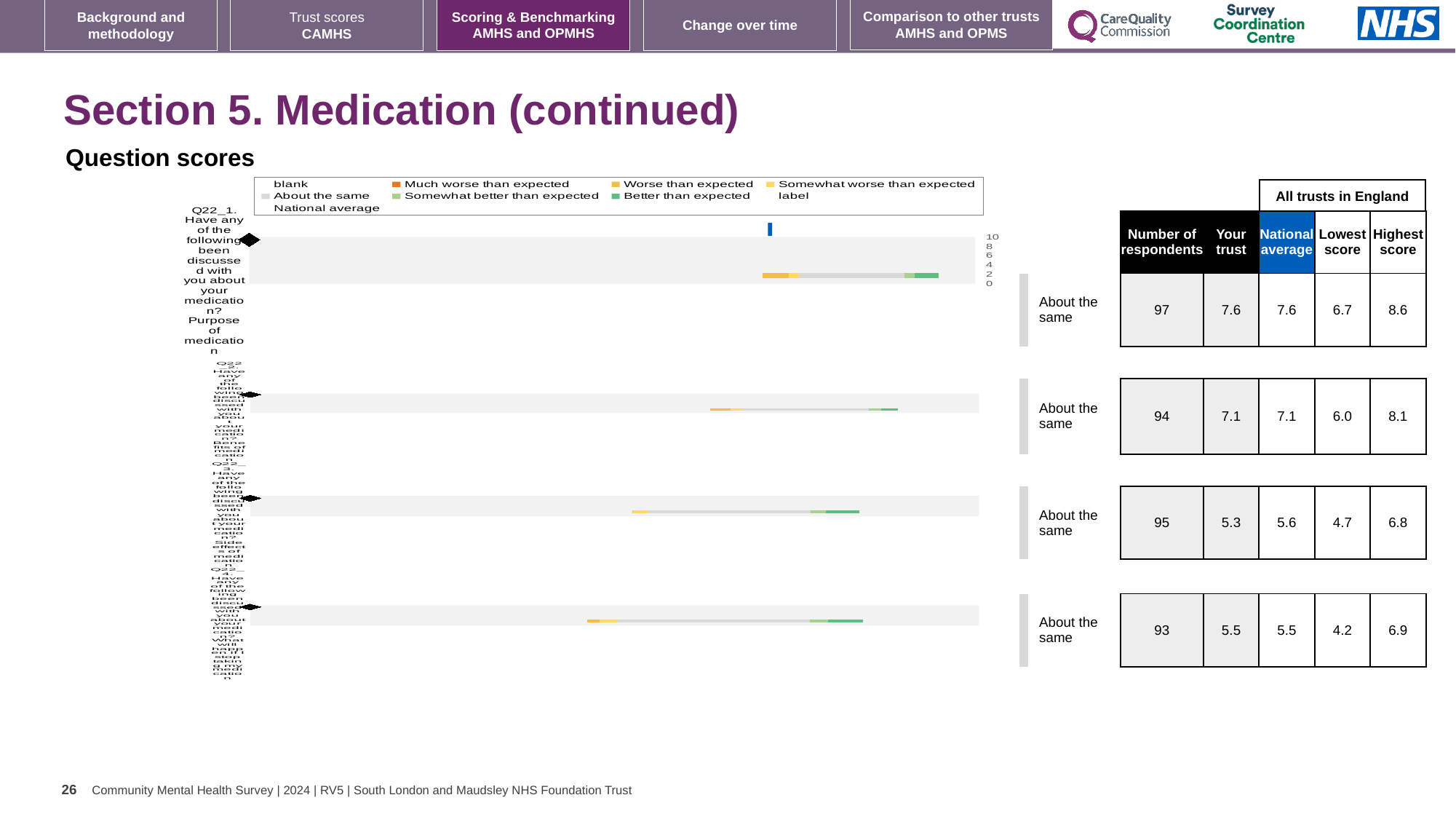
Which question row has the highest 'Your trust' score? Q22_1 (Purpose of medication) For the third question row (Q22_3), which is larger: the 'Your trust' score or the national average? National average What is the lowest score across all trusts in England for the second question row (Q22_2)? 6.0 Which question row has the lowest 'Your trust' score? Q22_3 (Side effects of medication) How many respondents are listed for the second question row (Q22_2)? 94 For the fourth question row (Q22_4), what is the difference between the highest score and the lowest score across all trusts in England? 2.7 What is the national average for the fourth question row (Q22_4)? 5.5 What is the highest tick value shown on the chart's score axis? 10 How many question rows (bars) are plotted in the chart? 4 What is the 'Your trust' score for Q22_1 (Purpose of medication)? 7.6 What benchmark category is shown next to each of the four question rows? About the same What kind of chart is shown under 'Question scores'? bar chart